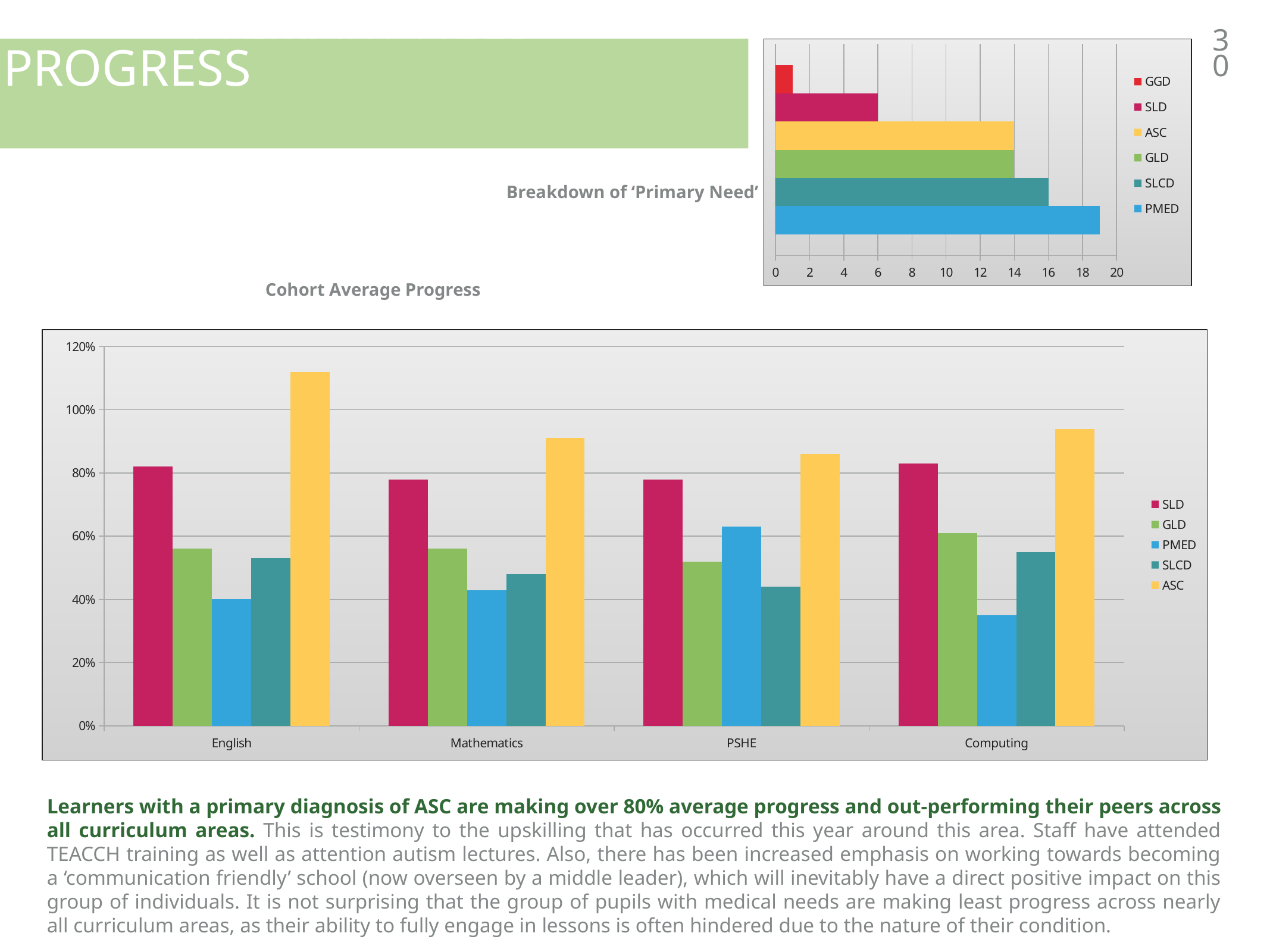
How many series does the legend of the 'Breakdown of 'Primary Need'' chart list? 6 How many subject categories are shown on the x axis of the 'Cohort Average Progress' chart? 4 What kind of chart is the 'Cohort Average Progress' chart? bar chart In the 'Breakdown of 'Primary Need'' chart, what is the value for SLD? 6 In the 'Cohort Average Progress' chart, is the PMED value for Computing greater or less than 40%? less In the 'Cohort Average Progress' chart, is the SLCD value for PSHE greater or less than 60%? less In the 'Cohort Average Progress' chart, which series has the lowest value for Computing? PMED In the 'Cohort Average Progress' chart, is the ASC value for English greater or less than 100%? greater In the 'Breakdown of 'Primary Need'' chart, which category has the highest value? PMED In the 'Cohort Average Progress' chart, which series has the highest value for English? ASC In the 'Cohort Average Progress' chart, which is larger for Mathematics: the SLD value or the GLD value? SLD How many series does the legend of the 'Cohort Average Progress' chart list? 5